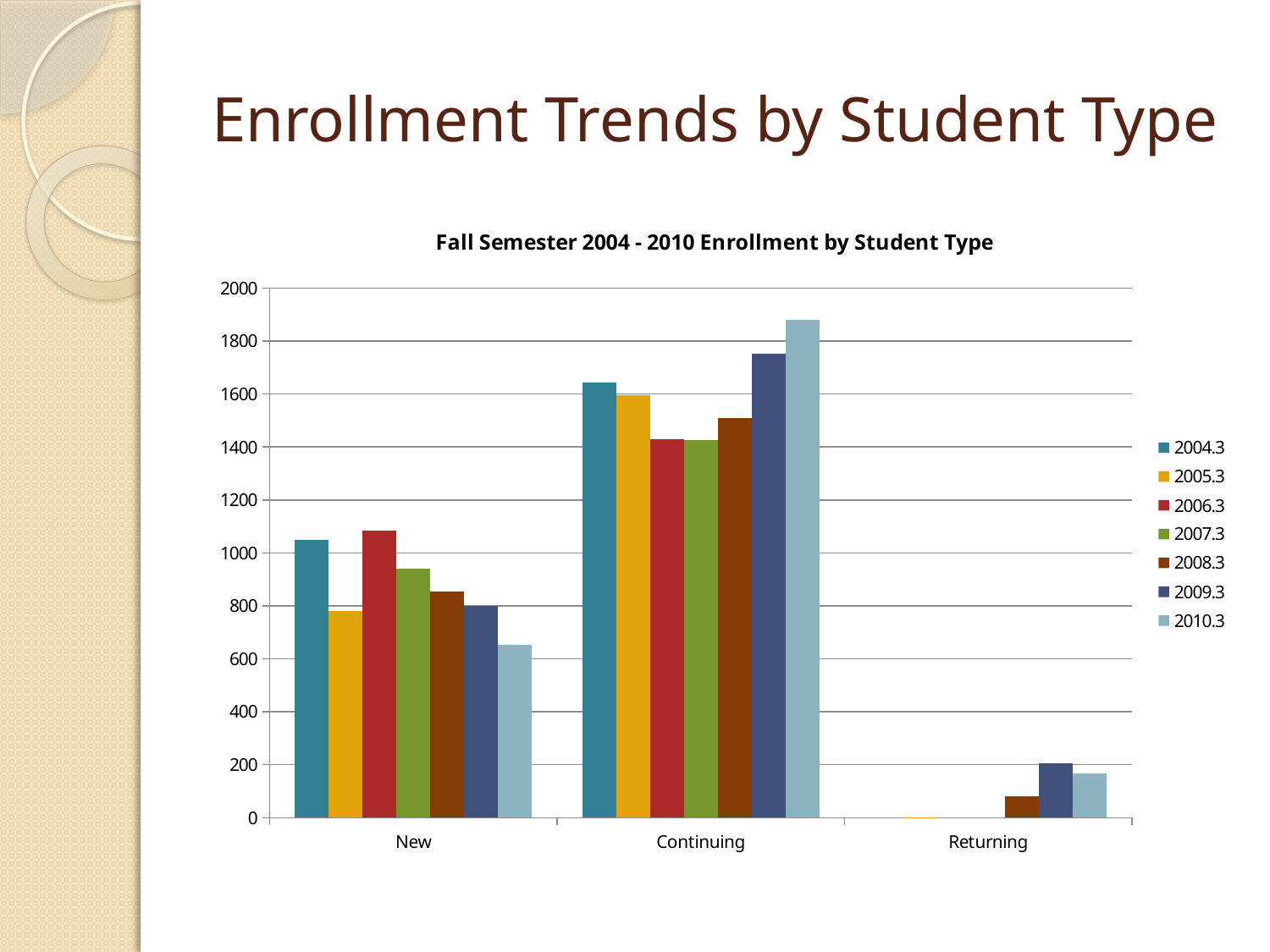
What is the title of the chart? Fall Semester 2004 - 2010 Enrollment by Student Type Is the value for Returning students in 2009.3 greater or less than 400? less Is the value for Continuing students in 2010.3 greater or less than 1800? greater Within the Continuing category, which year has the highest enrollment? 2010.3 What kind of chart is shown on the slide? bar chart For New students, which is larger: the 2005.3 value or the 2006.3 value? 2006.3 How many student type categories are shown on the x axis? 3 Which student type category has the tallest bars overall? Continuing Is the value for New students in 2004.3 greater or less than 1000? greater For Continuing students, which is larger: the 2004.3 value or the 2009.3 value? 2009.3 Within the New category, which year has the lowest enrollment? 2010.3 How many series does the legend list? 7